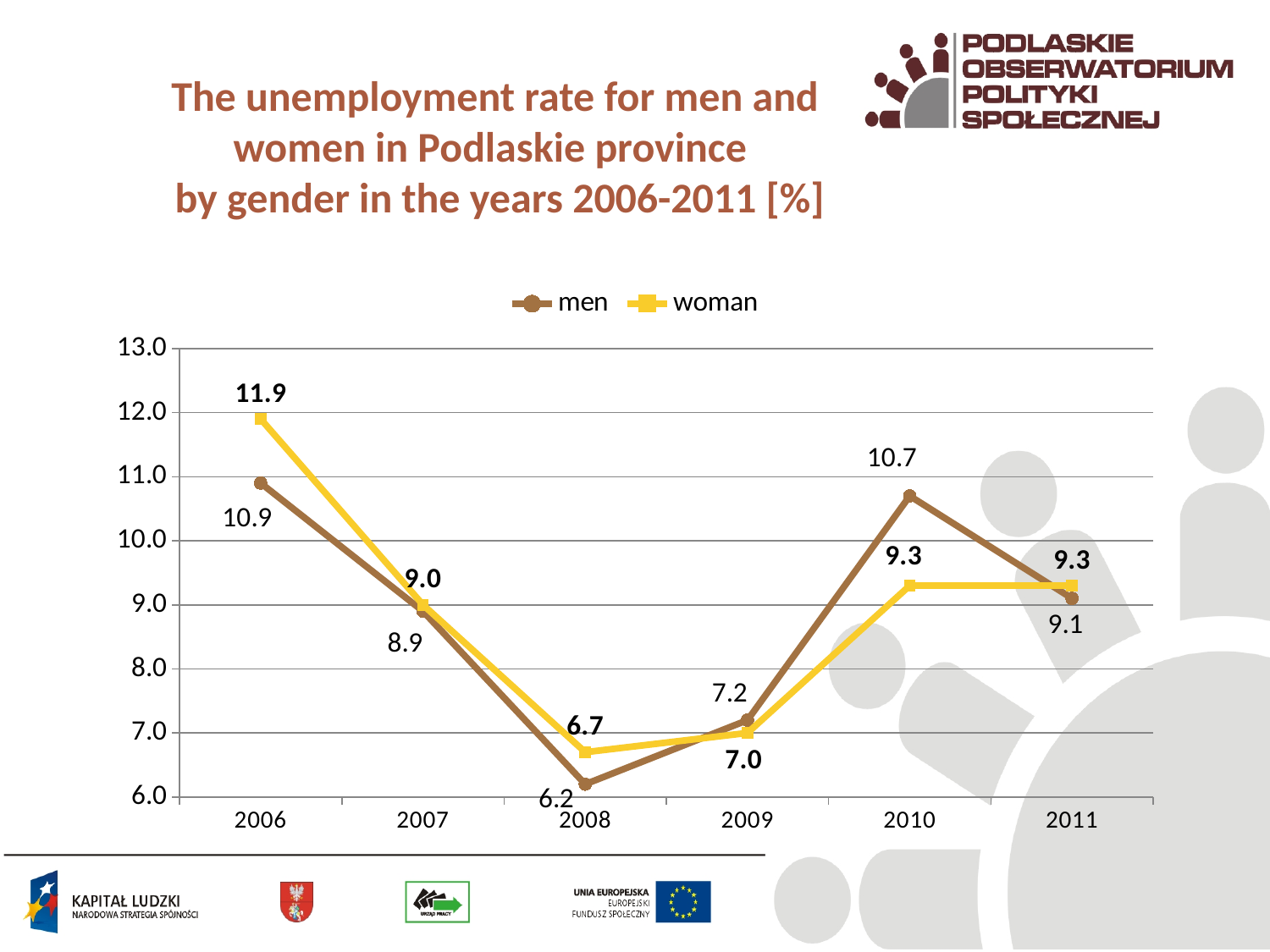
How many years are shown on the x axis? 6 What was the unemployment rate for men in 2010? 10.7 Which colour is used for the 'woman' series? yellow Which was higher in 2009, the unemployment rate for men or for women? men What is the difference between the unemployment rate for men and for women in 2010? 1.4 What was the unemployment rate for women in 2006? 11.9 In which year was the unemployment rate for men the lowest? 2008 What was the unemployment rate for men in 2008? 6.2 In which year was the unemployment rate for women the highest? 2006 Did the unemployment rate for women rise or fall from 2006 to 2008? fall What type of chart is shown on the slide? line chart How many series does the legend list? 2